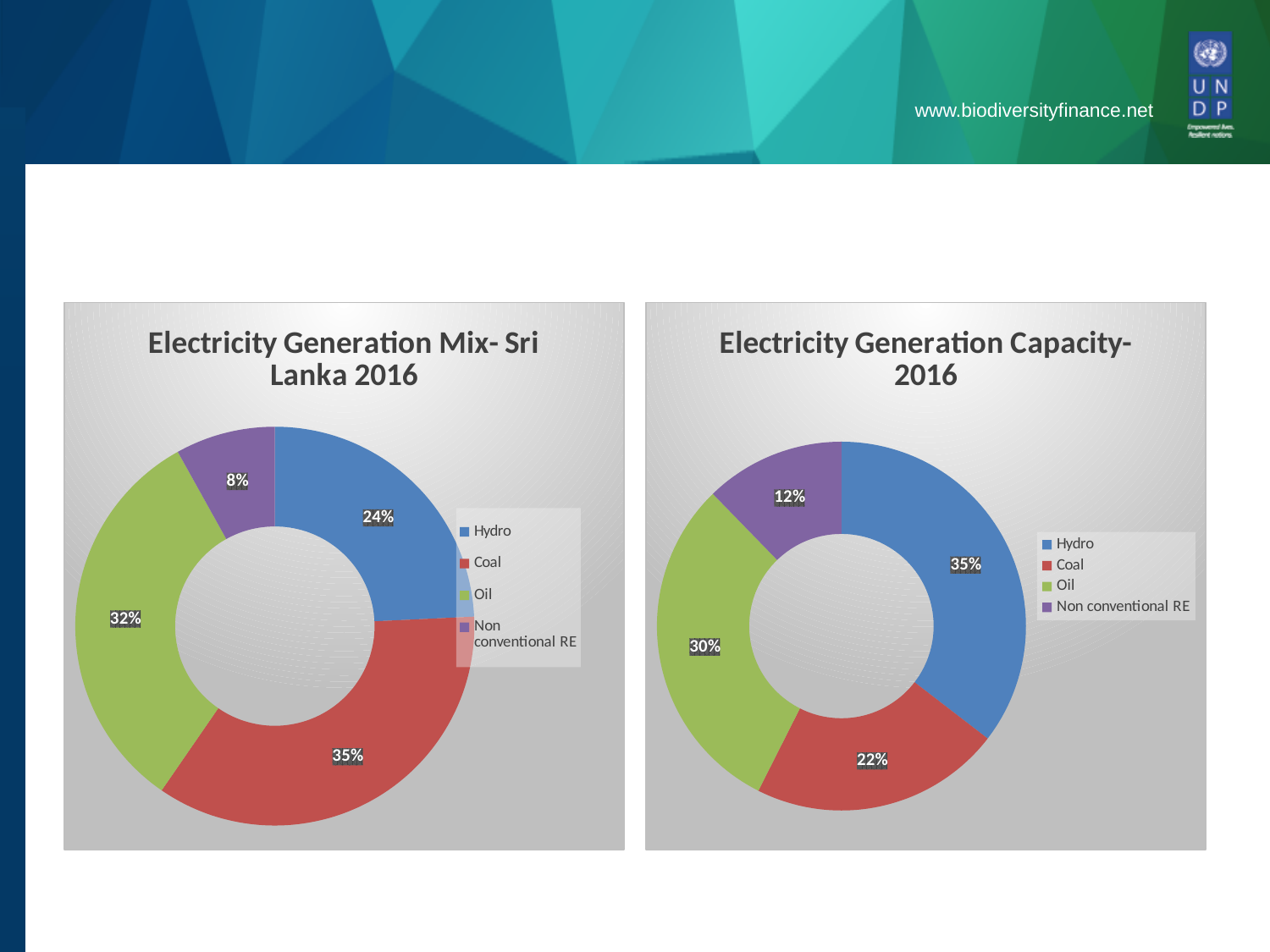
How many categories does the 'Electricity Generation Capacity- 2016' chart show? 4 What kind of chart is the 'Electricity Generation Mix- Sri Lanka 2016' chart? Doughnut (pie) chart In the 'Electricity Generation Capacity- 2016' chart, which category has the smallest share? Non conventional RE In the 'Electricity Generation Mix- Sri Lanka 2016' chart, what is the difference between the Oil share and the Non conventional RE share? 24% In the 'Electricity Generation Capacity- 2016' chart, which is larger, the Hydro share or the Coal share? Hydro In the 'Electricity Generation Mix- Sri Lanka 2016' chart, which category has the largest share? Coal In the 'Electricity Generation Capacity- 2016' chart, what share does Oil have? 30% What colour represents Oil in the 'Electricity Generation Mix- Sri Lanka 2016' chart? Green In the 'Electricity Generation Capacity- 2016' chart, what share does Non conventional RE have? 12% In the 'Electricity Generation Mix- Sri Lanka 2016' chart, what share does Coal have? 35% In the 'Electricity Generation Mix- Sri Lanka 2016' chart, what share does Hydro have? 24% In the 'Electricity Generation Capacity- 2016' chart, what is the difference between the Hydro share and the Coal share? 13%